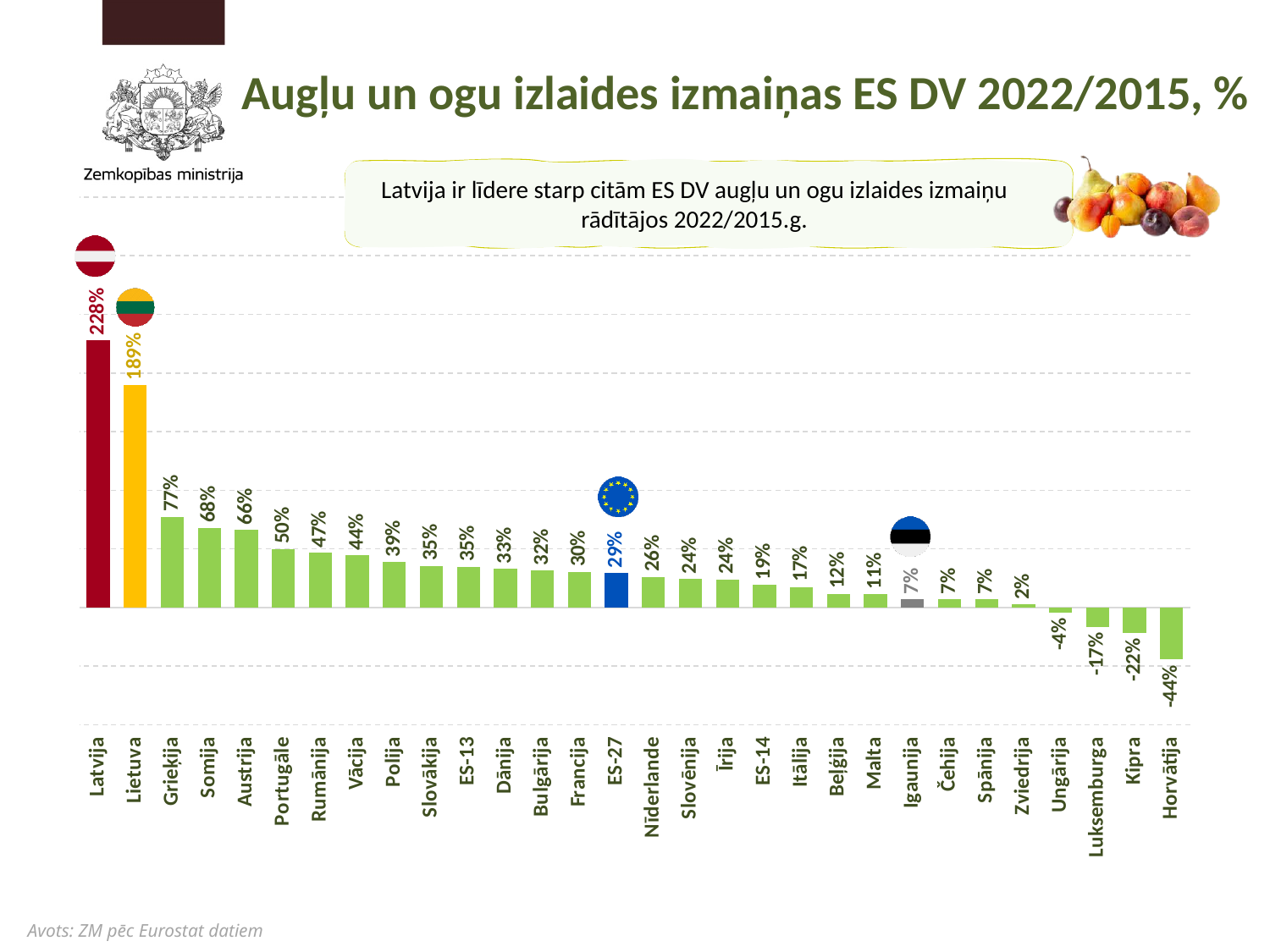
What kind of chart is shown on the slide? Bar chart Do the values rise or fall from left to right along the x axis? Fall Which country has the lowest value on the chart? Horvātija What is the difference between the values for Latvija and Lietuva? 39% Which has a larger value, Grieķija or Somija? Grieķija What is the value for Portugāle? 50% What is the value for ES-27? 29% Which country has the highest value on the chart? Latvija What is the value for Horvātija? -44% What is the value for Latvija? 228% How many categories are shown on the x axis? 30 What is the title of the chart? Augļu un ogu izlaides izmaiņas ES DV 2022/2015, %